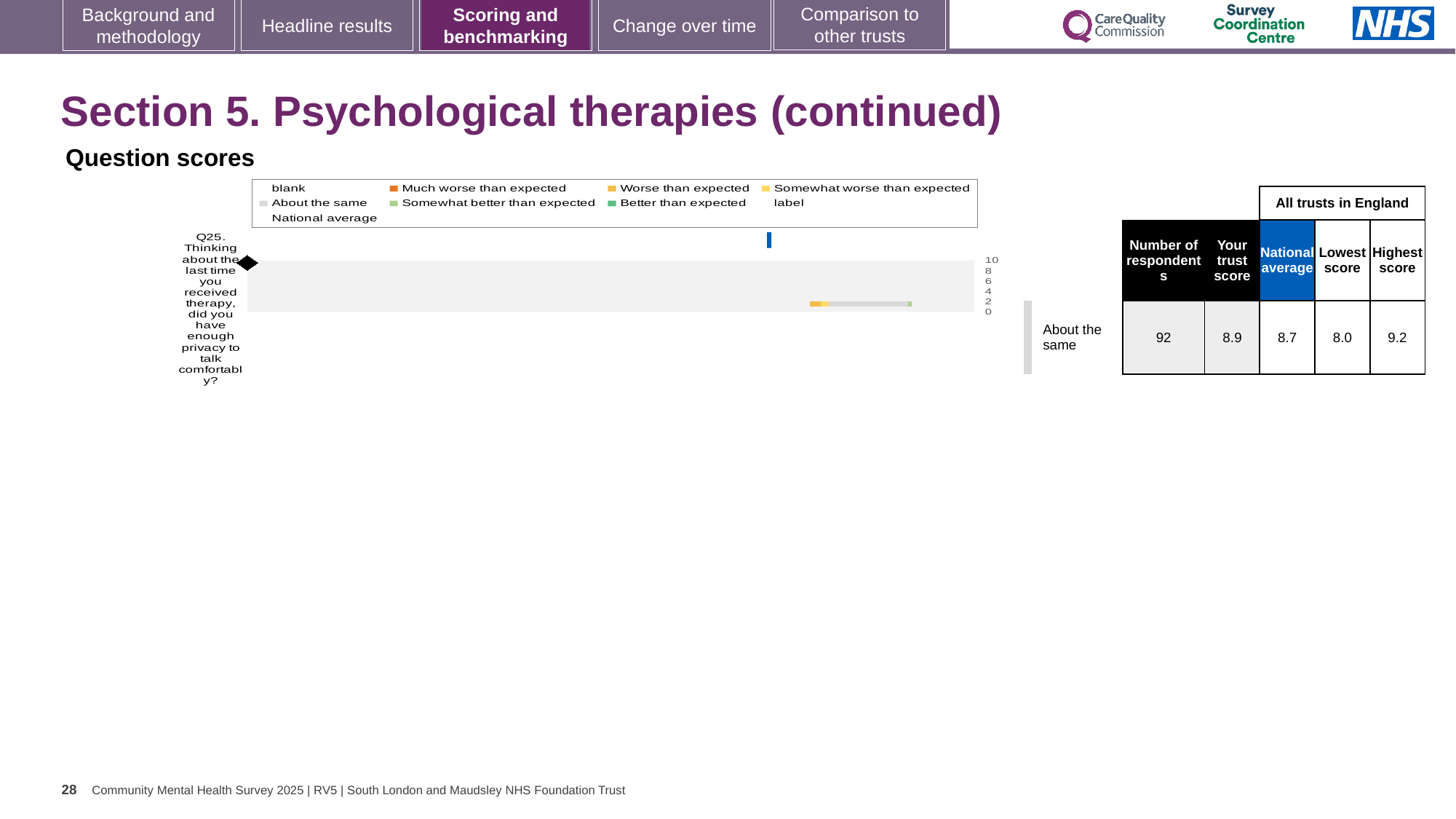
In the table next to the chart, what is the highest score among all trusts in England for Q25? 9.2 In the table next to the chart, what is the lowest score among all trusts in England for Q25? 8.0 What is the highest value shown on the score axis of the Question scores chart? 10 For Q25, which is larger: the trust's score or the national average? the trust's score In the table next to the chart, what is 'Your trust score' for Q25? 8.9 In the table next to the chart, what is the national average for Q25? 8.7 For Q25, what is the difference between the highest score and the lowest score among all trusts in England? 1.2 Which question number is plotted in the Question scores chart? Q25 How many questions (categories) are plotted in the Question scores chart? 1 In the table next to the chart, what is the number of respondents for Q25? 92 What kind of chart is shown under 'Question scores'? bar chart According to the benchmark label beside the chart, how does the trust's score for Q25 compare with what is expected? About the same